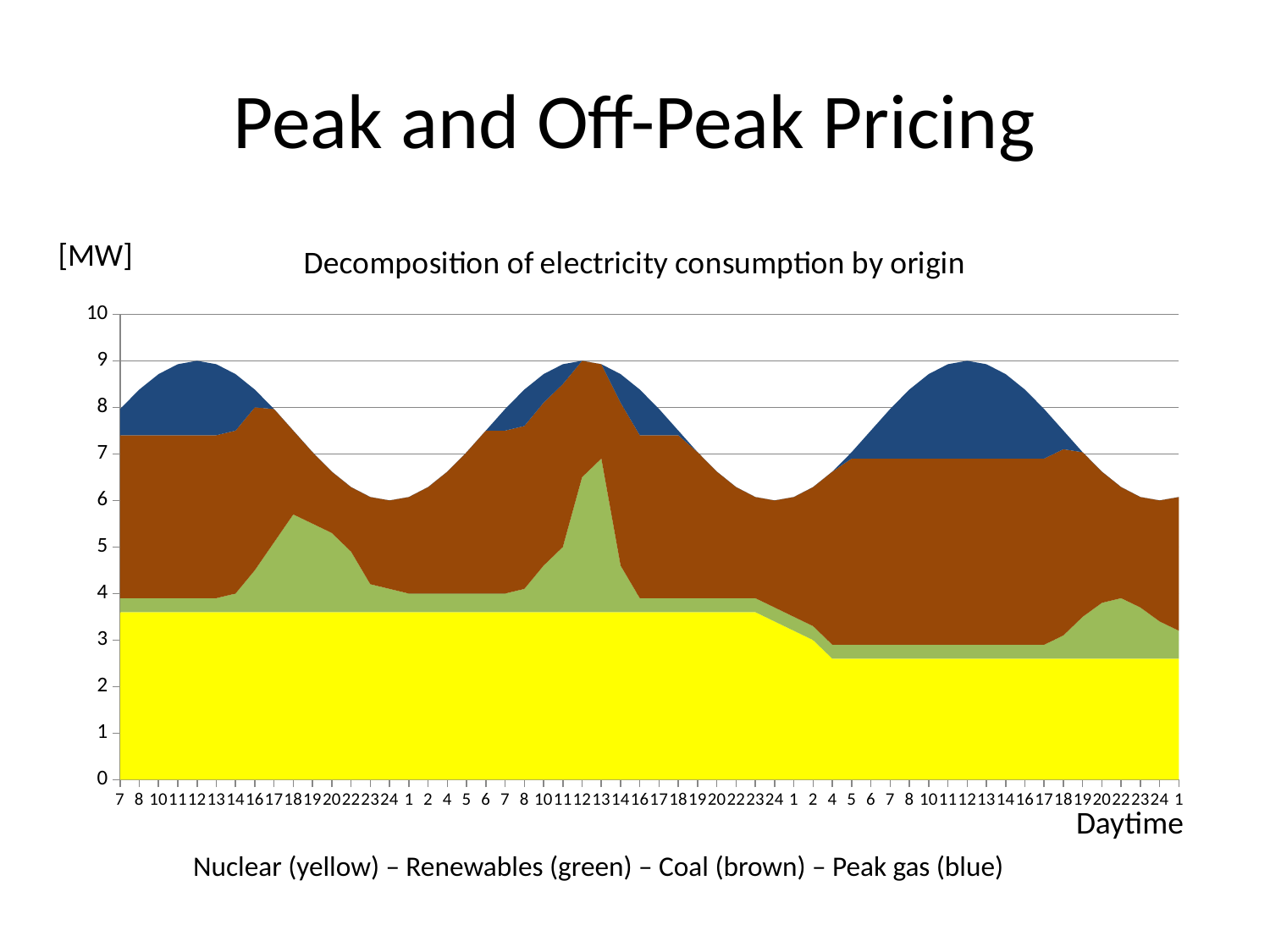
What kind of chart is shown on the slide? Stacked area chart Is the total consumption at the third daily peak (around hour 12 of the third day) greater or less than 8? greater Is the nuclear (yellow) value at the first hour (7) greater or less than 4? less Which series forms the bottom layer of the stack? Nuclear Is the total consumption at the first peak (around hour 12) greater or less than 10? less What is the title of the chart? Decomposition of electricity consumption by origin Which energy source is shown in yellow? Nuclear Does the nuclear (yellow) contribution rise or fall from the start to the end of the period? fall How many energy sources (series) are stacked in the chart? 4 What unit is shown for the vertical axis? [MW] Which energy source is shown in blue? Peak gas